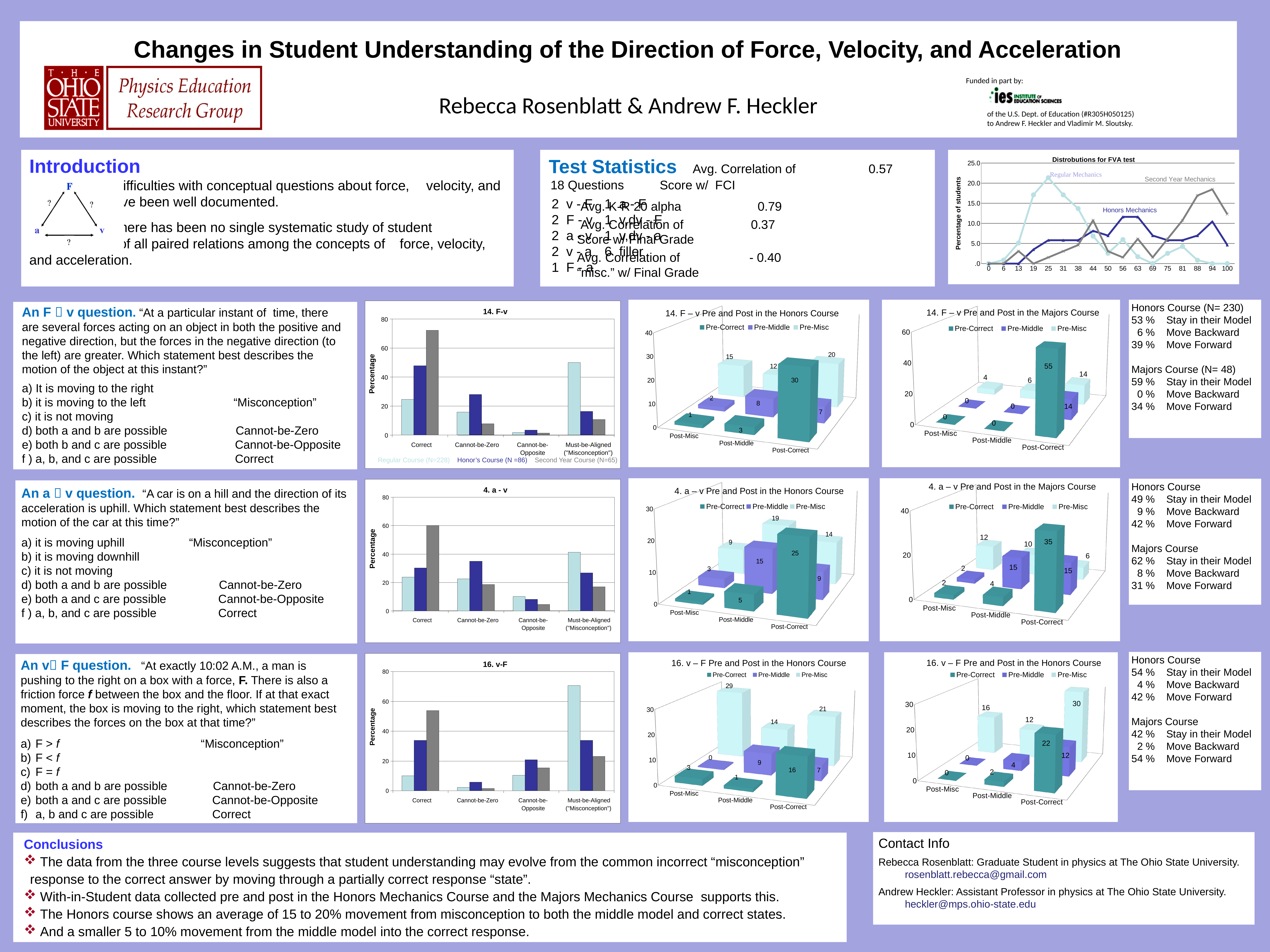
In the chart titled "16. v – F Pre and Post in the Honors Course" in the middle column, what is the value of the Pre-Misc series at Post-Misc? 29 In the bar chart titled "14. F-v", is the Regular Course value for Must-be-Aligned ("Misconception") greater or less than 40? greater In the chart titled "14. F – v Pre and Post in the Honors Course", what is the value of the Pre-Correct series at Post-Correct? 30 What kind of chart is the one titled "Distrobutions for FVA test"? line chart In the chart titled "14. F – v Pre and Post in the Honors Course", how many series does the legend list? 3 In the chart titled "4. a – v Pre and Post in the Honors Course", which is larger: the Pre-Misc value at Post-Middle or the Pre-Correct value at Post-Correct? Pre-Correct at Post-Correct In the chart titled "14. F – v Pre and Post in the Majors Course", what is the difference between the Pre-Correct and Pre-Middle values at Post-Correct? 41 In the chart titled "4. a – v Pre and Post in the Honors Course", what is the value of the Pre-Middle series at Post-Middle? 15 In the chart titled "14. F – v Pre and Post in the Majors Course", what is the value of the Pre-Correct series at Post-Correct? 55 How many categories are shown on the x axis of the bar chart titled "16. v-F"? 4 In the bar chart titled "14. F-v", which category has the highest Second Year Course bar? Correct In the chart titled "4. a – v Pre and Post in the Majors Course", what is the value of the Pre-Correct series at Post-Correct? 35